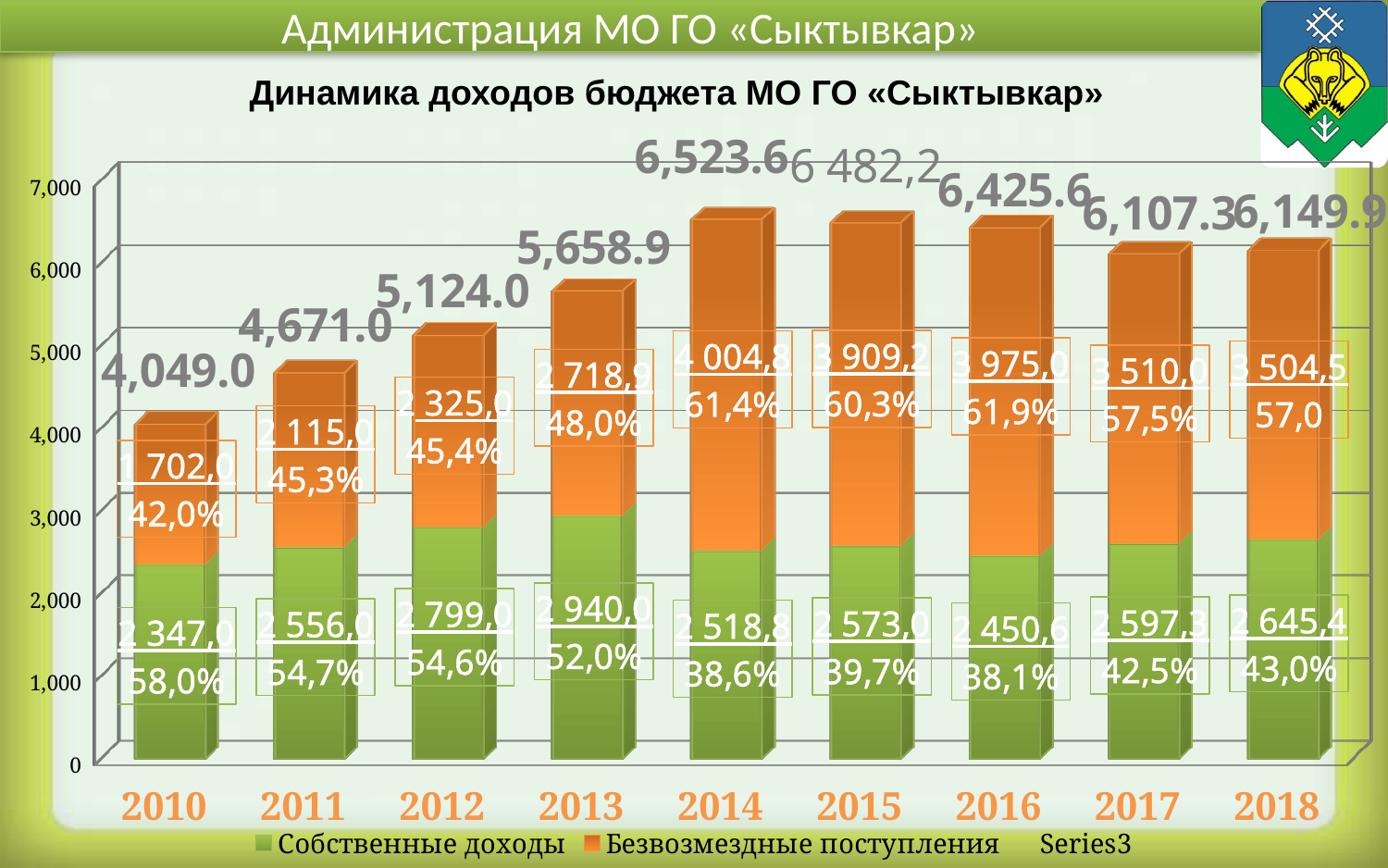
Do the total budget incomes rise or fall from 2010 to 2014? Rise What is the value of Собственные доходы for 2013? 2 940,0 What share of the 2017 total do Собственные доходы make up, as labelled on the bar? 42,5% How many years are shown on the x axis? 9 What is the value of Безвозмездные поступления for 2014? 4 004,8 How many series does the legend list? 3 Which year has the lowest value of Безвозмездные поступления? 2010 What is the difference between Безвозмездные поступления in 2015 and in 2016? 65,8 Which year has the highest total budget income? 2014 What kind of chart is shown on the slide? Stacked bar chart Which is larger in 2012: Собственные доходы or Безвозмездные поступления? Собственные доходы What is the total shown above the bar for 2016? 6,425.6